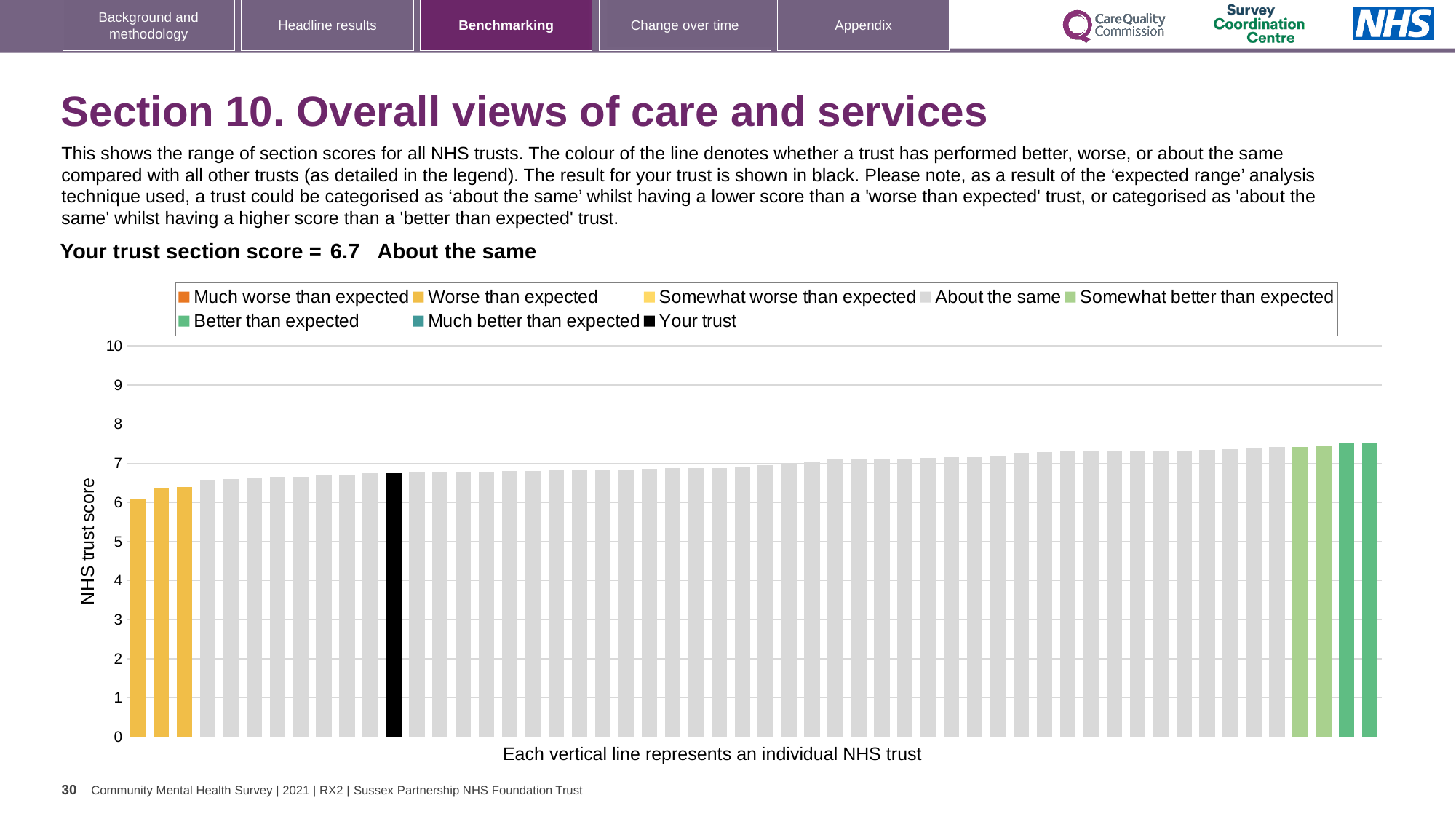
Which category is your trust placed in according to the slide? About the same Is the value of the lowest bar in the chart greater or less than 7? less How many bars are coloured green (somewhat better or better than expected) in the chart? 4 What kind of chart is shown on the slide? bar chart What is the section score for your trust shown on the slide? 6.7 How many entries does the chart legend list? 8 Is the value of the highest bar in the chart greater or less than 7? greater Is the value for your trust (the black bar) greater or less than 5? greater How many bars are coloured as 'Worse than expected' (yellow) in the chart? 3 What is the label on the y axis of the chart? NHS trust score Do the bar values rise or fall from left to right along the x axis? rise